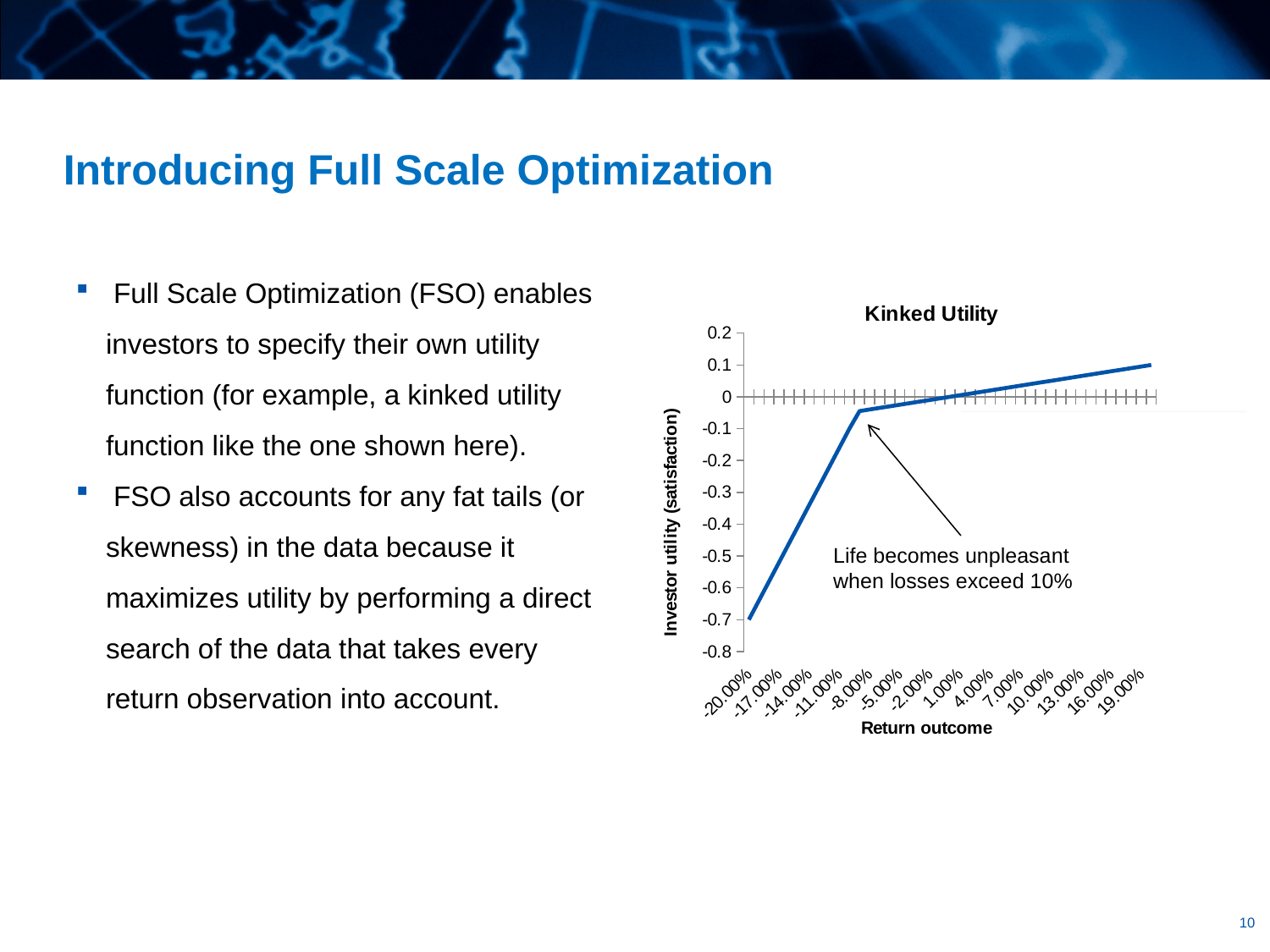
Do the values on the chart rise or fall as the return outcome increases along the x axis? rise What is the lowest value labelled on the y axis? -0.8 What is the title of the chart? Kinked Utility How many return outcome labels are shown on the x axis? 14 What kind of chart is shown on the slide? line chart At which return outcome is investor utility lowest? -20.00% Is the investor utility at a return outcome of -20.00% greater or less than -0.5? less Is the investor utility at a return outcome of -8.00% greater or less than -0.3? greater Is the investor utility at a return outcome of 19.00% greater or less than 0? greater What does the annotation on the chart say? Life becomes unpleasant when losses exceed 10% Which has the larger investor utility: a return outcome of -20.00% or 19.00%? 19.00%